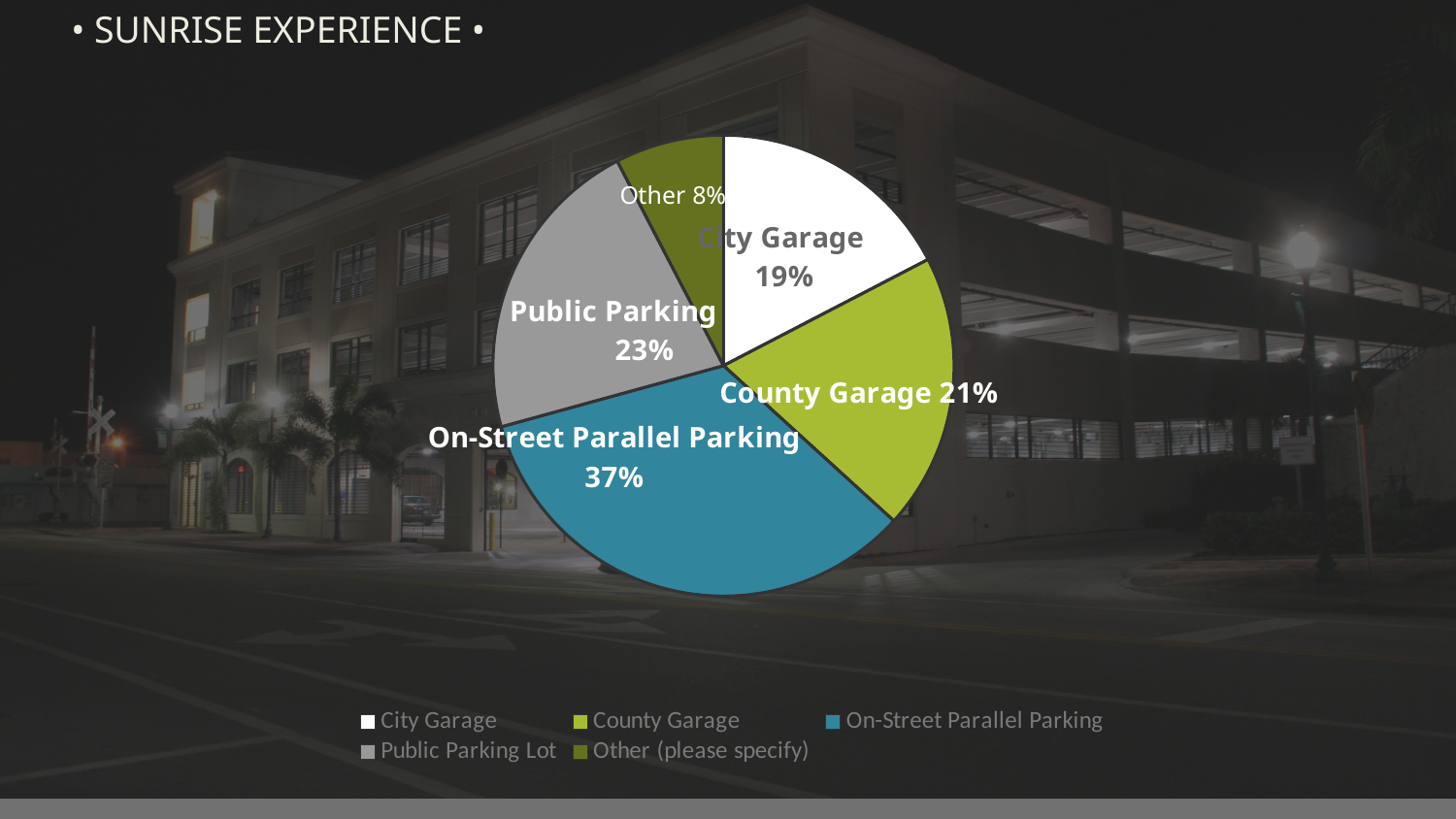
What percentage of the pie is County Garage? 21% What percentage of the pie is Other? 8% What kind of chart is shown on the slide? Pie chart What percentage of the pie is On-Street Parallel Parking? 37% How many slices does the pie chart have? 5 Which category has the smallest share of the pie? Other What is the difference in percentage points between On-Street Parallel Parking and City Garage? 18 What percentage of the pie is City Garage? 19% How many entries does the legend list? 5 What percentage of the pie is Public Parking? 23% Which category has the largest share of the pie? On-Street Parallel Parking Which is larger, the share for Public Parking or the share for County Garage? Public Parking